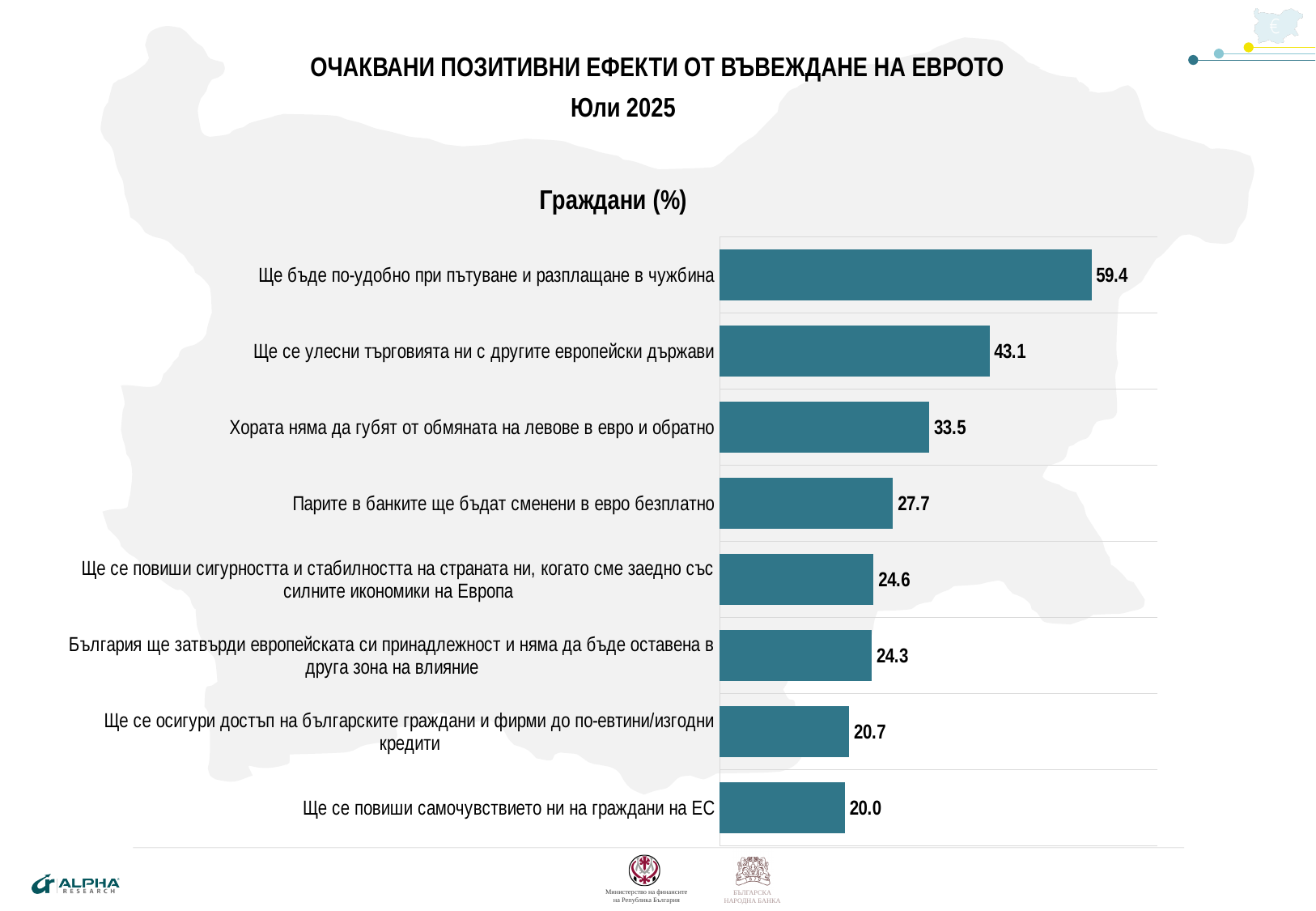
What is the difference between the values for "Ще бъде по-удобно при пътуване и разплащане в чужбина" and "Ще се улесни търговията ни с другите европейски държави"? 16.3 Which category has the highest value? Ще бъде по-удобно при пътуване и разплащане в чужбина What is the title shown directly above the chart? Граждани (%) What kind of chart is shown on the slide? Bar chart What is the value for "Парите в банките ще бъдат сменени в евро безплатно"? 27.7 Do the values rise or fall going from the top bar to the bottom bar? Fall What is the difference between the values for "Хората няма да губят от обмяната на левове в евро и обратно" and "Парите в банките ще бъдат сменени в евро безплатно"? 5.8 What is the value for "Ще се осигури достъп на българските граждани и фирми до по-евтини/изгодни кредити"? 20.7 What is the value for "Ще бъде по-удобно при пътуване и разплащане в чужбина"? 59.4 Which category has the lowest value? Ще се повиши самочувствието ни на граждани на ЕС How many categories are shown in the chart? 8 Which is larger: the value for "Ще се улесни търговията ни с другите европейски държави" or for "Хората няма да губят от обмяната на левове в евро и обратно"? Ще се улесни търговията ни с другите европейски държави